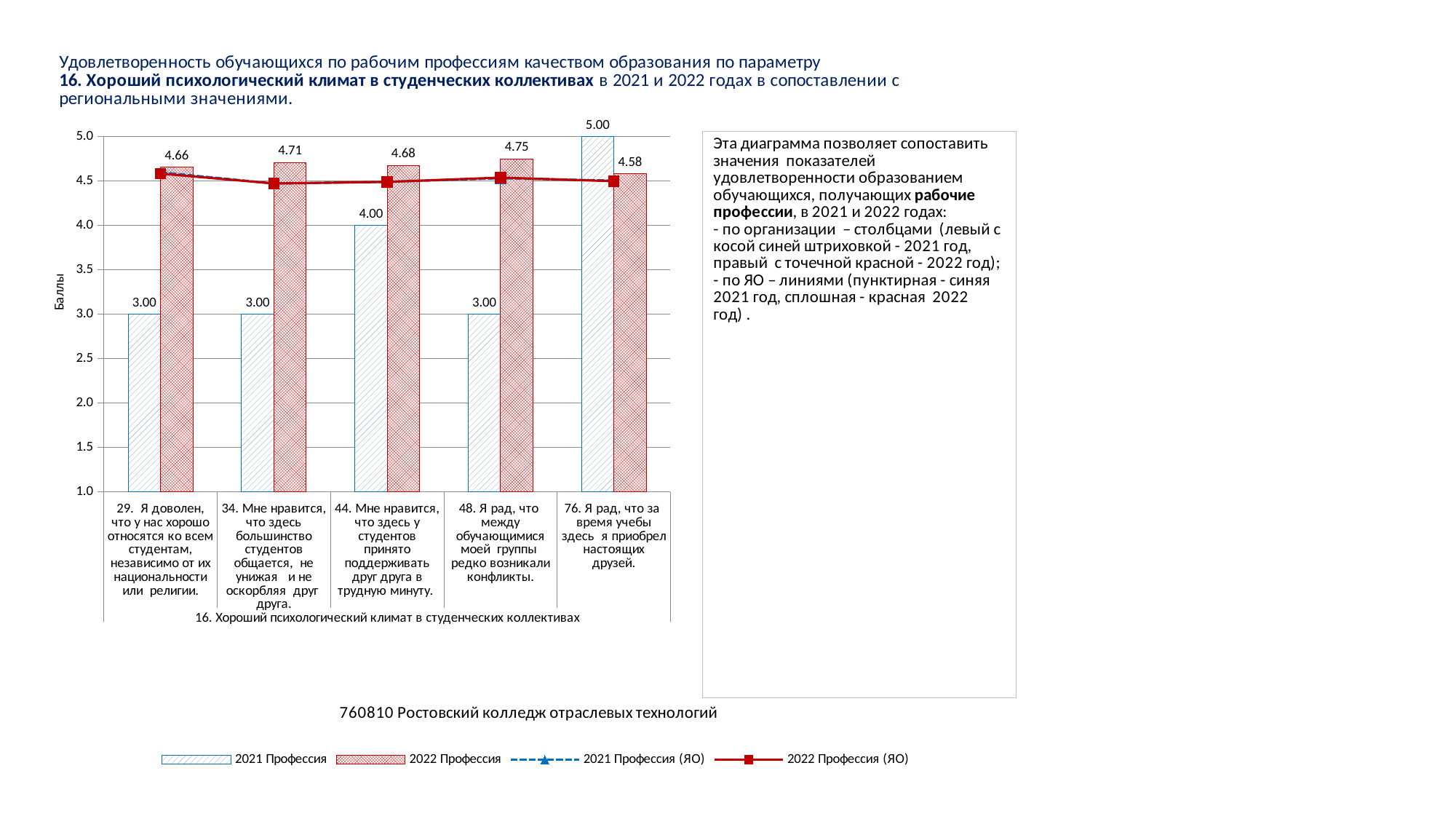
How many series does the legend list? 4 What type of chart is used for the 2021 Профессия and 2022 Профессия series? Bar chart What is the difference between the 2022 Профессия and 2021 Профессия values for item 29? 1.66 What is the 2021 Профессия value for item 76 (Я рад, что за время учебы здесь я приобрел настоящих друзей)? 5.00 Which item has the lowest 2022 Профессия value? 76. Я рад, что за время учебы здесь я приобрел настоящих друзей. What is the 2021 Профессия value for item 44 (Мне нравится, что здесь у студентов принято поддерживать друг друга в трудную минуту)? 4.00 What is the label of the vertical axis? Баллы What is the 2022 Профессия value for item 48 (Я рад, что между обучающимися моей группы редко возникали конфликты)? 4.75 How many items (categories) are shown on the x axis? 5 Is the 2022 Профессия (ЯО) line value for item 34 greater or less than 4.0? greater For item 76, which is larger: the 2021 Профессия value or the 2022 Профессия value? 2021 Профессия Which item has the highest 2022 Профессия value? 48. Я рад, что между обучающимися моей группы редко возникали конфликты.